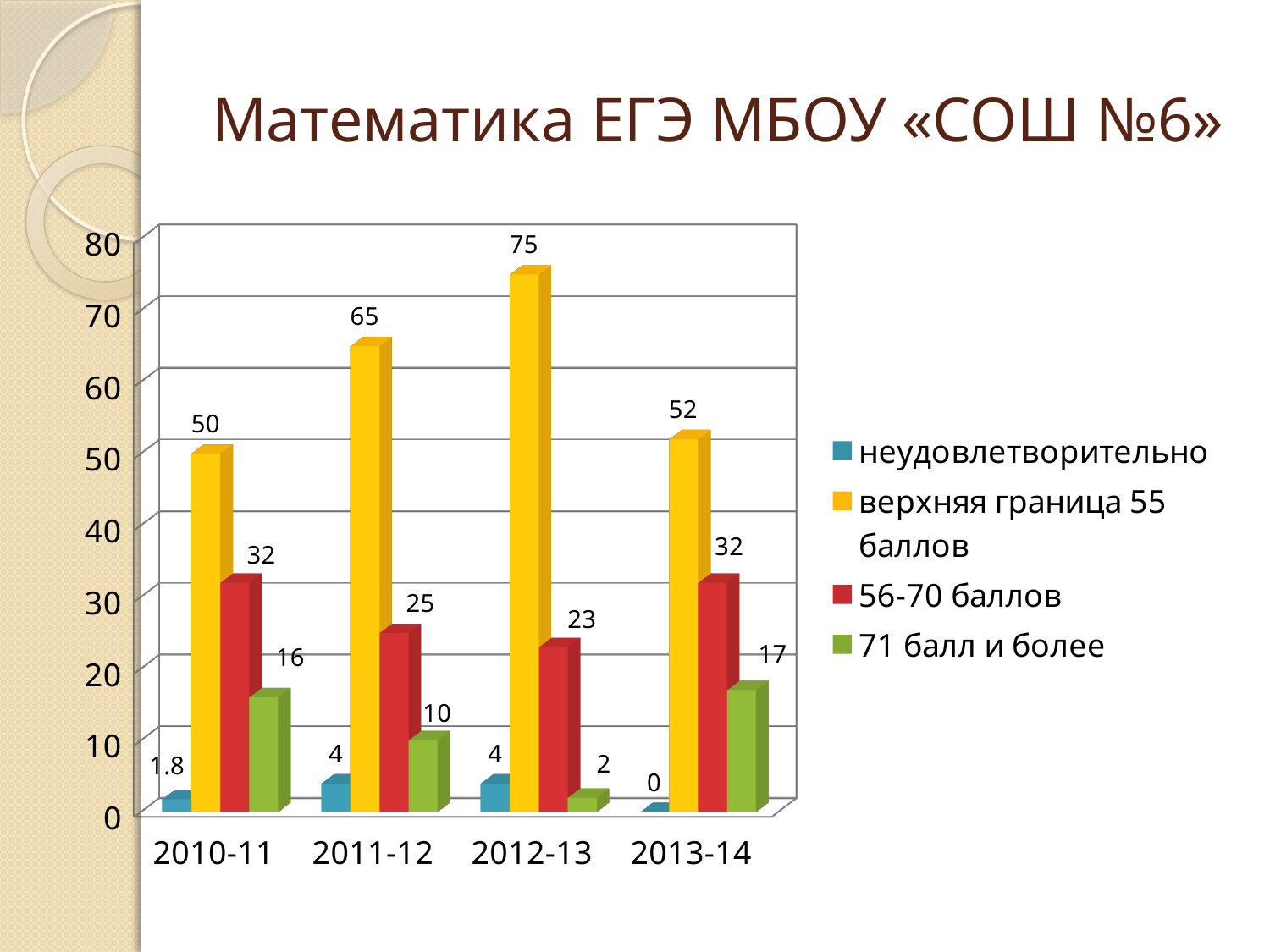
What is the value for "неудовлетворительно" in 2010-11? 1.8 How many series does the legend list? 4 What kind of chart is shown on the slide? bar chart What is the title of the slide? Математика ЕГЭ МБОУ «СОШ №6» What is the value for "71 балл и более" in 2013-14? 17 What is the difference between the "верхняя граница 55 баллов" values for 2012-13 and 2013-14? 23 In which year is the value for "71 балл и более" lowest? 2012-13 How many years are shown on the x axis? 4 What is the value for "верхняя граница 55 баллов" in 2012-13? 75 In which year is the value for "верхняя граница 55 баллов" highest? 2012-13 Which is larger: the "56-70 баллов" value in 2010-11 or in 2012-13? 2010-11 What is the value for "56-70 баллов" in 2011-12? 25